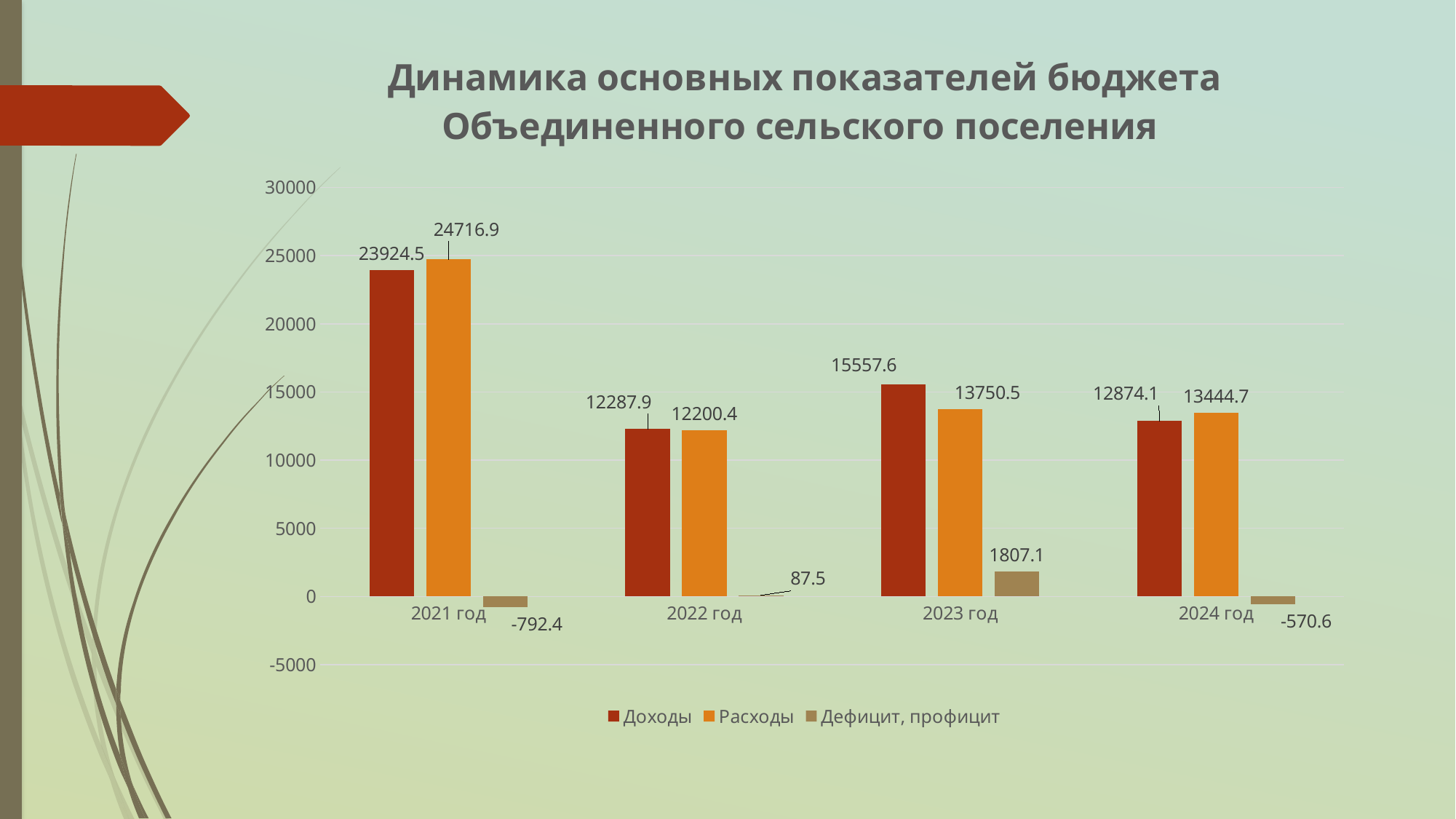
In which year is Расходы the lowest? 2022 год How many years are shown on the x axis? 4 What is the value of Доходы for 2021 год? 23924.5 In 2024 год, which is larger: Доходы or Расходы? Расходы What is the value of Расходы for 2024 год? 13444.7 What is the value of Дефицит, профицит for 2023 год? 1807.1 What is the value of Дефицит, профицит for 2021 год? -792.4 How many series does the legend list? 3 Is the value of Доходы for 2023 год greater or less than 15000? greater In which year is Доходы the highest? 2021 год What is the difference between Доходы and Расходы in 2023 год? 1807.1 What kind of chart is shown on the slide? bar chart